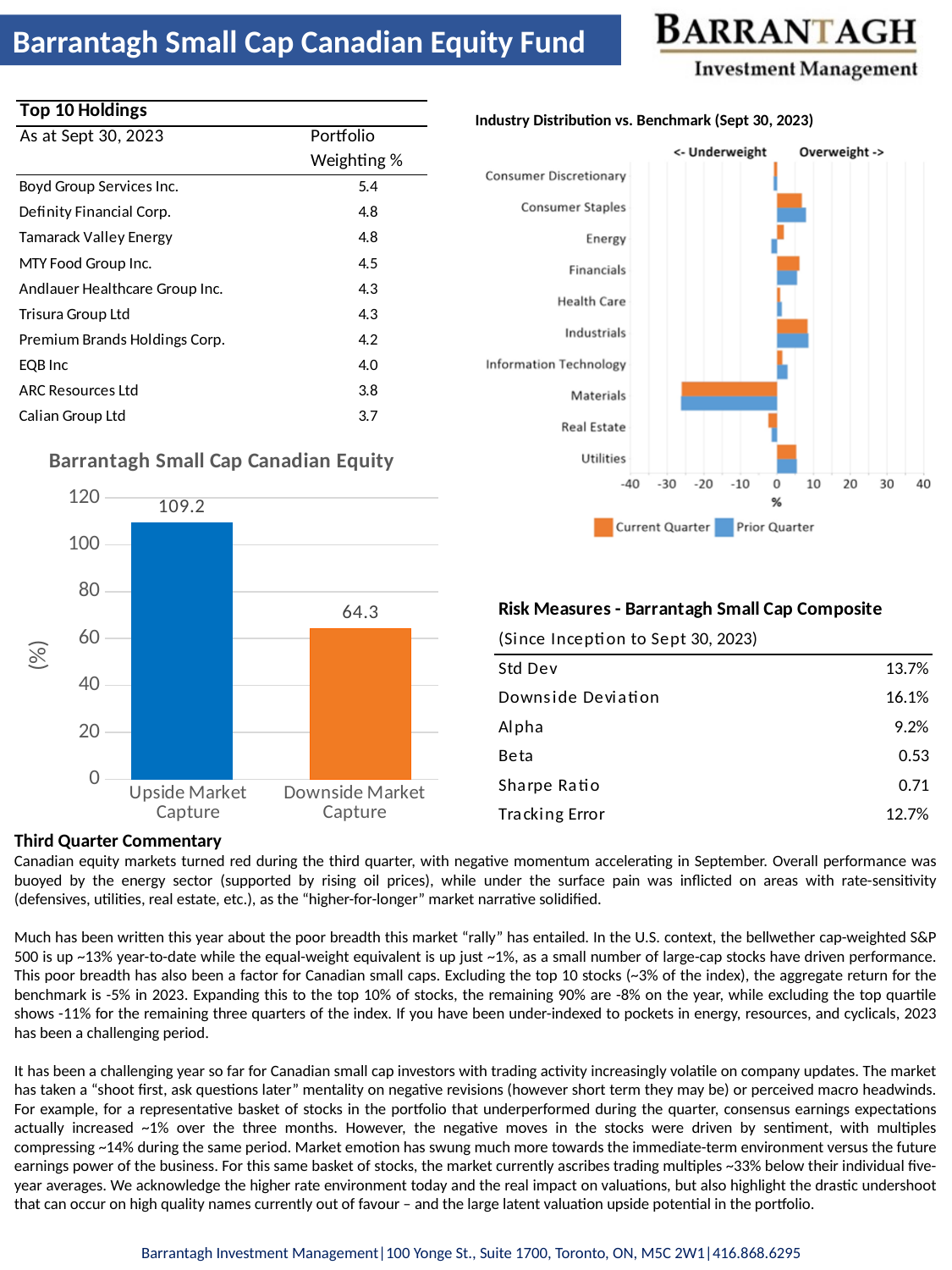
In the Barrantagh Small Cap Canadian Equity chart, what is the value for Downside Market Capture? 64.3 What kind of chart is the Barrantagh Small Cap Canadian Equity chart? bar chart In the Industry Distribution vs. Benchmark chart, which colour represents the Prior Quarter series? blue How many industry categories are shown in the Industry Distribution vs. Benchmark chart? 10 In the Barrantagh Small Cap Canadian Equity chart, is the value for Upside Market Capture greater or less than 100? greater In the Barrantagh Small Cap Canadian Equity chart, which is larger, Upside Market Capture or Downside Market Capture? Upside Market Capture How many categories are shown in the Barrantagh Small Cap Canadian Equity chart? 2 In the Industry Distribution vs. Benchmark chart, is the Current Quarter value for Materials greater or less than -20? less In the Barrantagh Small Cap Canadian Equity chart, what is the value for Upside Market Capture? 109.2 In the Barrantagh Small Cap Canadian Equity chart, what is the difference between Upside Market Capture and Downside Market Capture? 44.9 In the Industry Distribution vs. Benchmark chart, which industry has the lowest (most underweight) Current Quarter value? Materials How many series does the legend of the Industry Distribution vs. Benchmark chart list? 2